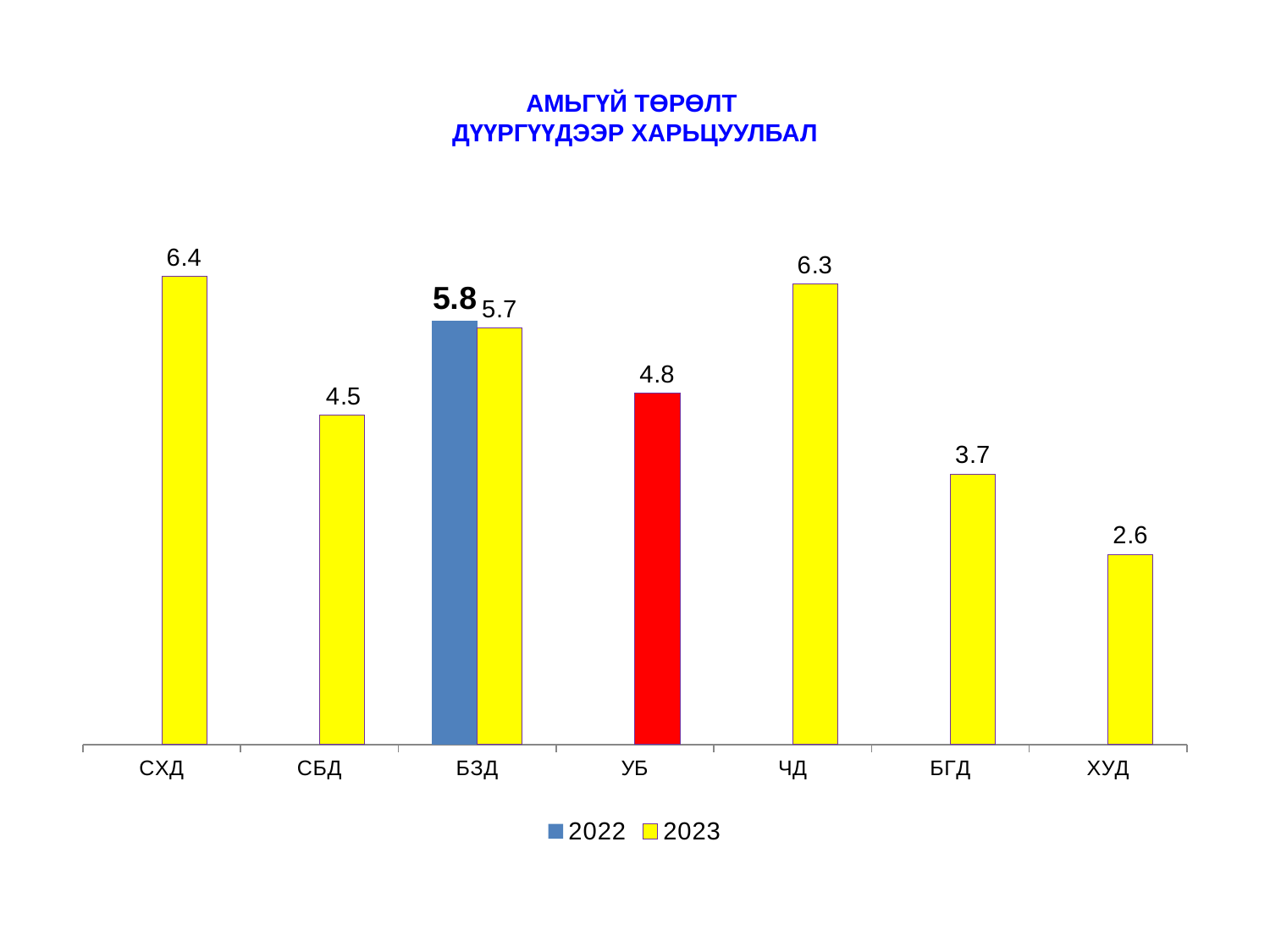
How many series does the legend list? 2 Which category has the lowest 2023 value? ХУД What is the difference between the 2022 and 2023 values for БЗД? 0.1 What is the 2023 value for БГД? 3.7 Which is larger, the 2023 value for СБД or the value for УБ? УБ What is the 2023 value for СХД? 6.4 Which category has the highest 2023 value? СХД What is the value shown for УБ? 4.8 What kind of chart is shown on the slide? Bar chart What is the 2022 value for БЗД? 5.8 What is the difference between the 2023 values for ЧД and БГД? 2.6 How many categories are shown on the x axis? 7